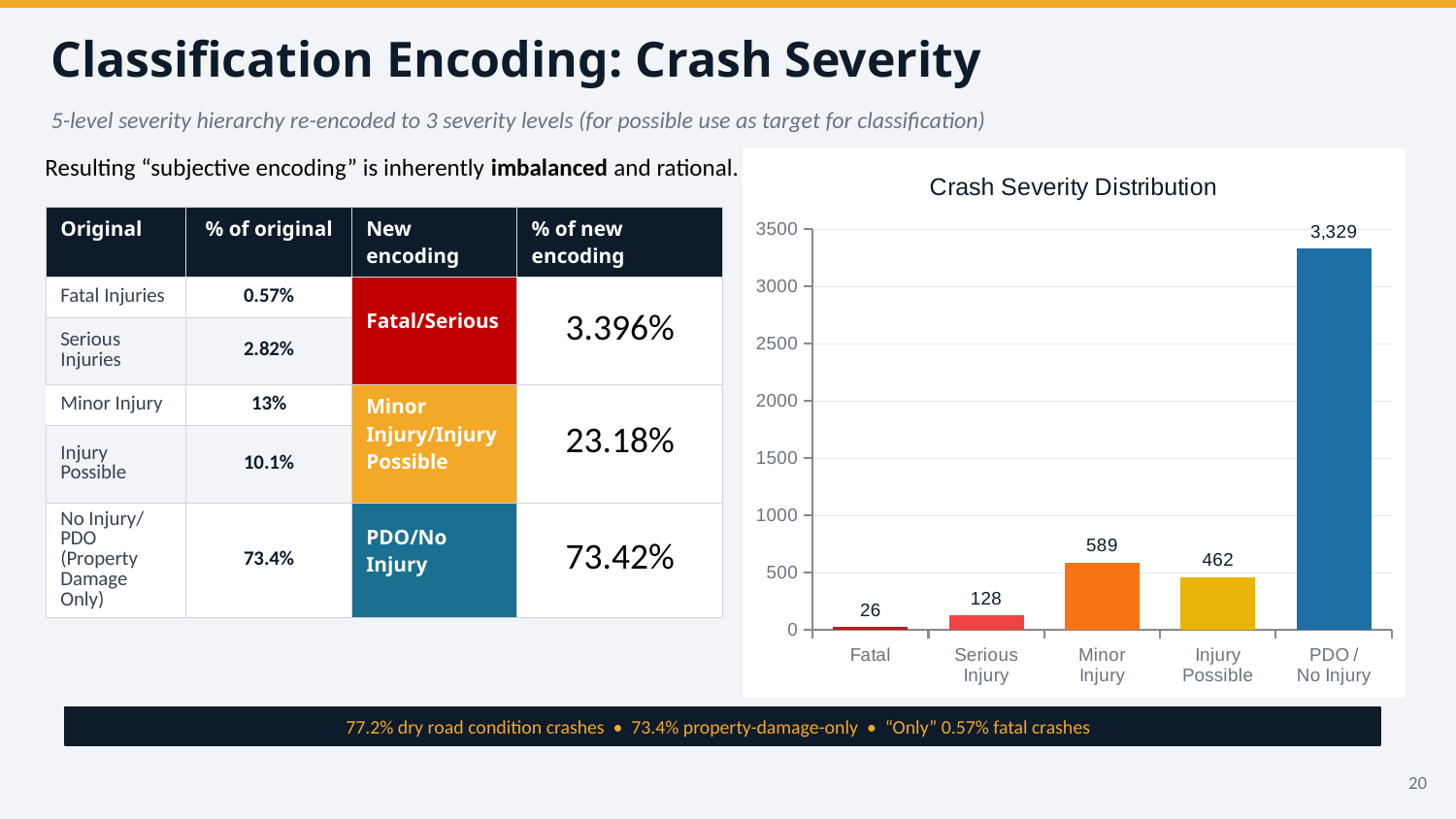
What is the title of the chart on the slide? Crash Severity Distribution What is the value for PDO / No Injury in the Crash Severity Distribution chart? 3,329 What is the difference between the Minor Injury and Injury Possible values in the Crash Severity Distribution chart? 127 Which is larger in the Crash Severity Distribution chart, Serious Injury or Injury Possible? Injury Possible Which category has the highest value in the Crash Severity Distribution chart? PDO / No Injury What is the value for Minor Injury in the Crash Severity Distribution chart? 589 What kind of chart is the Crash Severity Distribution chart? bar chart What is the value for Serious Injury in the Crash Severity Distribution chart? 128 Is the value for PDO / No Injury greater or less than 3000 in the Crash Severity Distribution chart? greater Which category has the lowest value in the Crash Severity Distribution chart? Fatal What is the value for Fatal in the Crash Severity Distribution chart? 26 How many categories are shown in the Crash Severity Distribution chart? 5